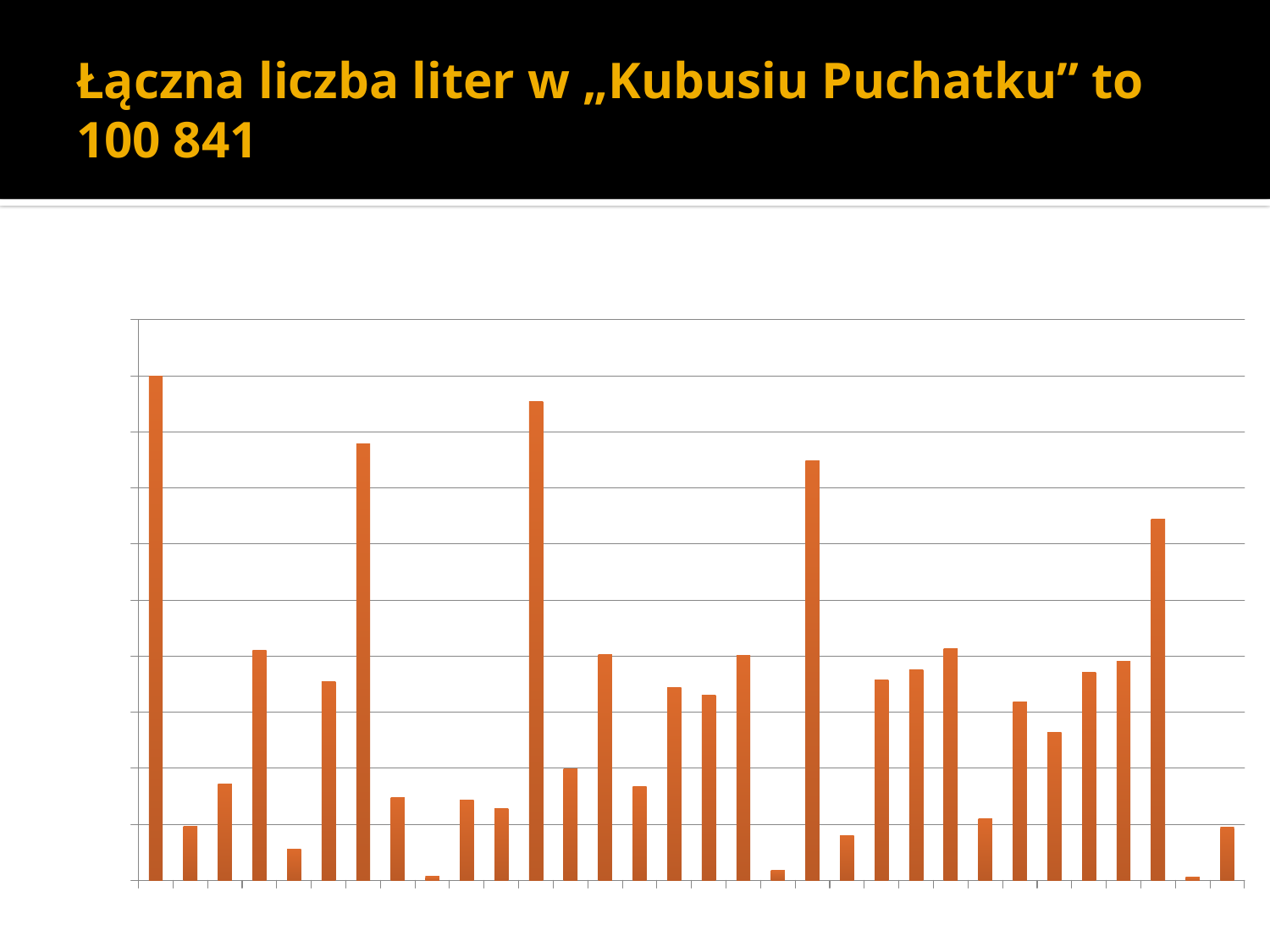
What colour are the bars in the chart? orange Which is taller, the first bar from the left or the second bar from the left? the first bar What kind of chart is shown on the slide? bar chart How many bars does the chart contain? 32 Which bar in the chart is the tallest, by position from the left? the first bar Does the chart show any data labels on the bars? no What is the title of the slide above the chart? Łączna liczba liter w „Kubusiu Puchatku” to 100 841